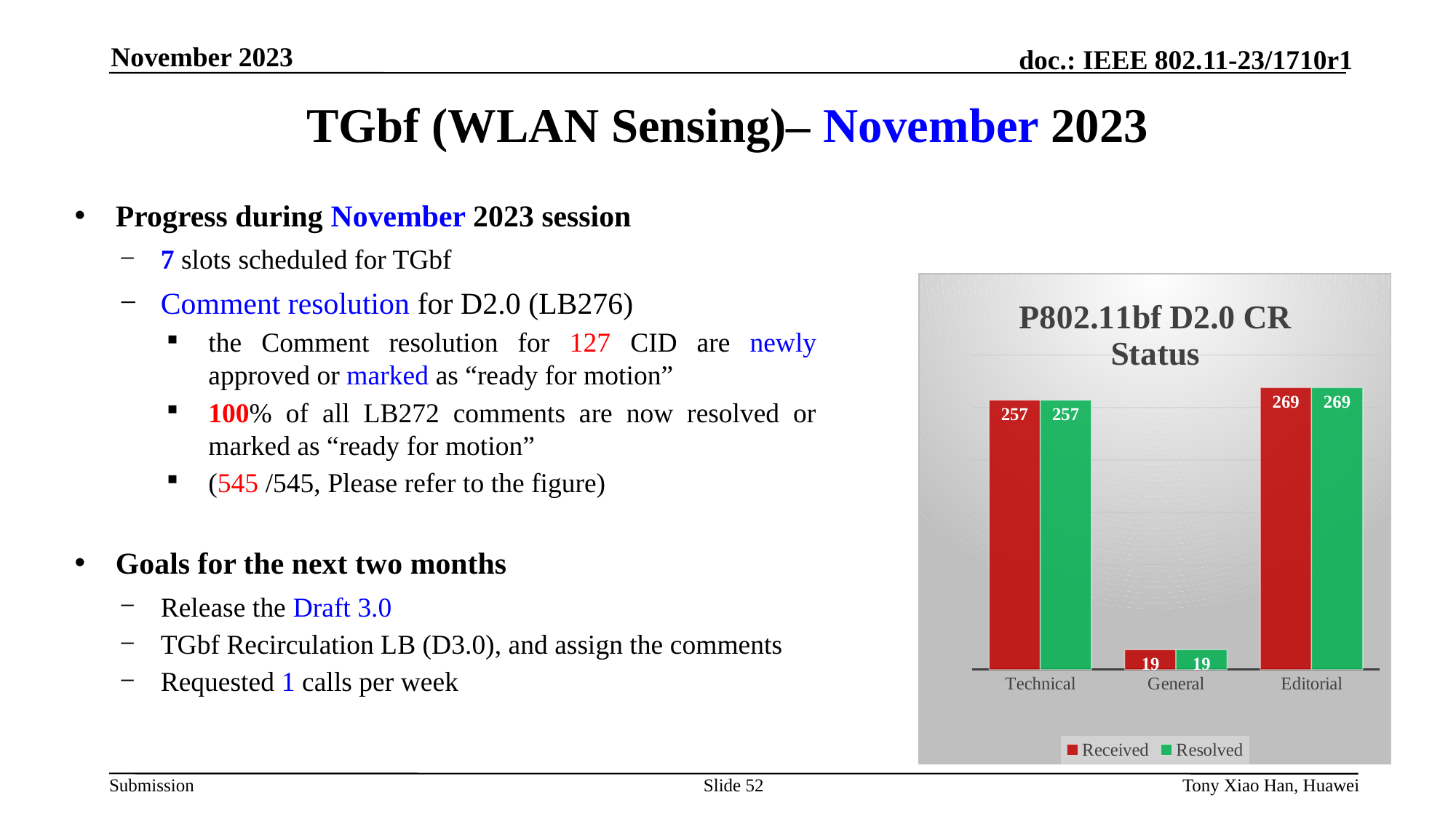
Which is larger, the Resolved value for Technical or the Resolved value for Editorial? Editorial What kind of chart is shown? bar chart Which category has the lowest Resolved value? General What is the title of the chart? P802.11bf D2.0 CR Status What is the Received value for Technical? 257 What is the Received value for Editorial? 269 Which category has the highest Received value? Editorial How many series does the legend list? 2 What is the Resolved value for General? 19 How many categories are shown on the x axis? 3 What is the difference between the Received values for Technical and General? 238 What is the difference between the Received values for Editorial and Technical? 12